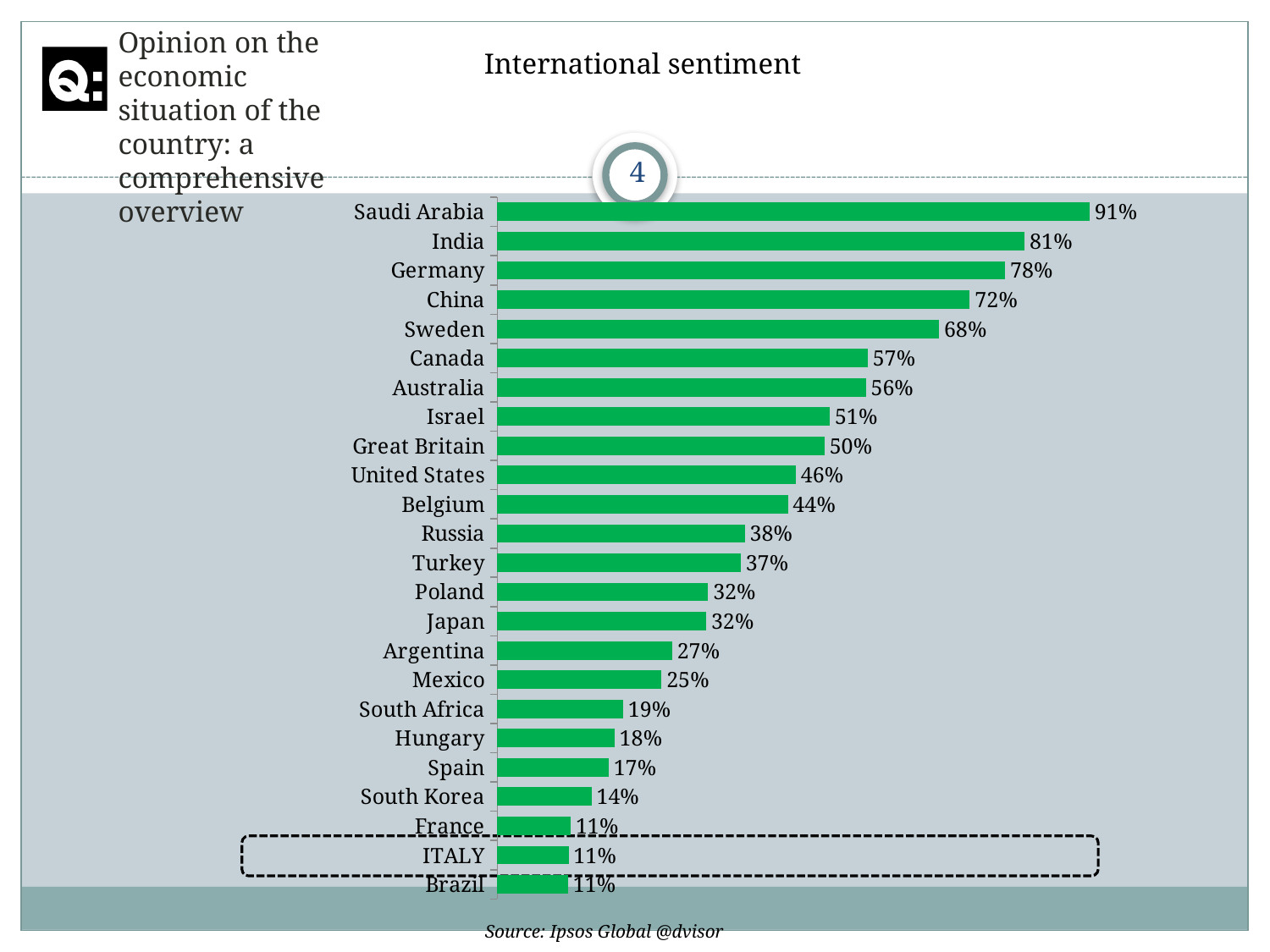
What is the title of the chart? International sentiment How many countries are shown in the chart? 24 What is the value for ITALY? 11% Which has a larger value, Sweden or Australia? Sweden Which country is highlighted with a dashed box? ITALY Which has a larger value, Russia or Mexico? Russia What is the value for Canada? 57% What kind of chart is shown on the slide? Bar chart What is the difference between the values for Great Britain and Spain? 33% What is the difference between the values for India and China? 9% Which country has the highest value? Saudi Arabia What is the value for Germany? 78%